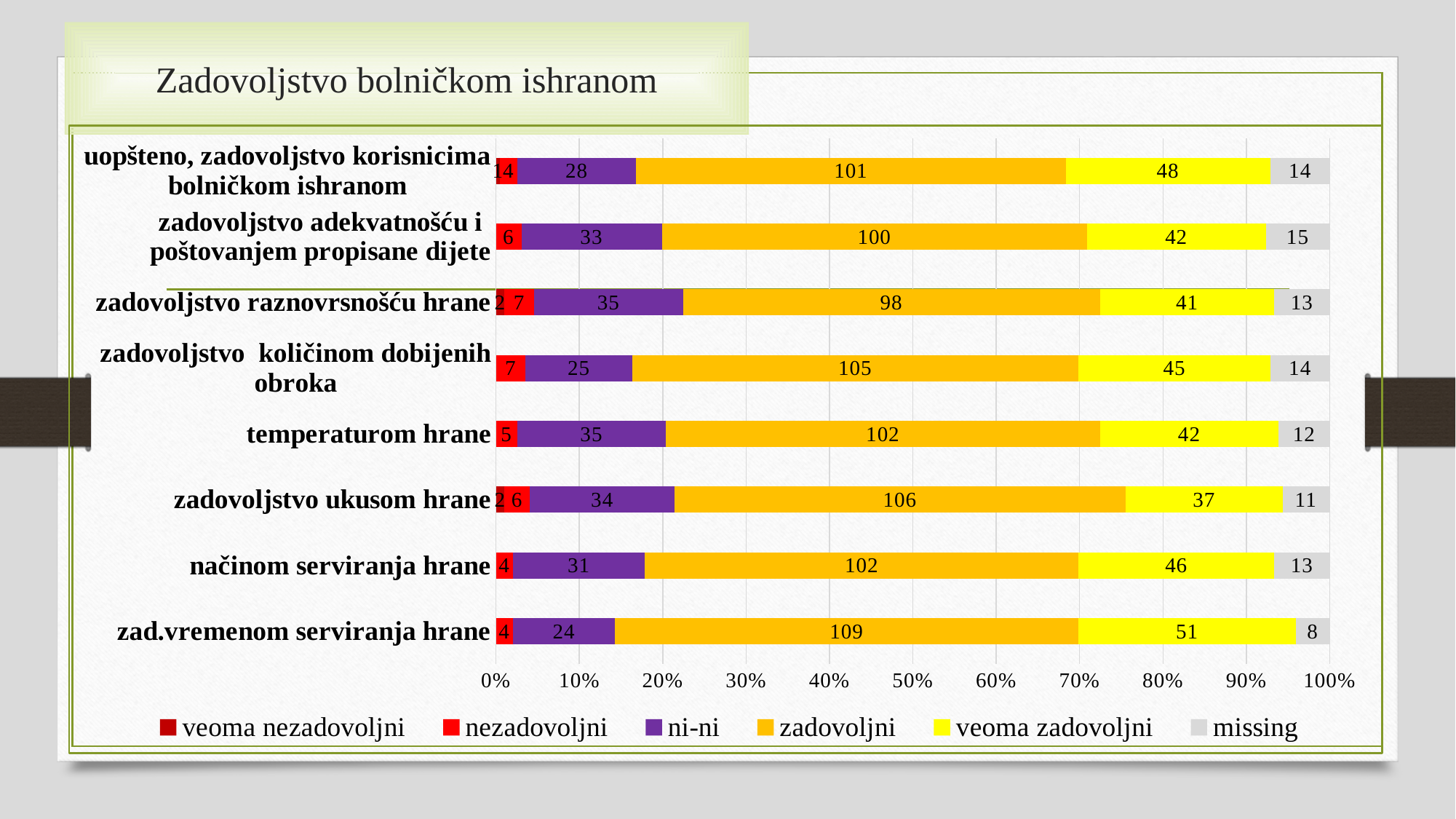
How many categories are plotted on the chart? 8 Which category has the lowest 'missing' value? zad.vremenom serviranja hrane What is the 'veoma zadovoljni' value for 'zadovoljstvo ukusom hrane'? 37 What is the difference between the 'veoma zadovoljni' values for 'zad.vremenom serviranja hrane' and 'zadovoljstvo ukusom hrane'? 14 How many series does the legend list? 6 What is the 'zadovoljni' value for 'zad.vremenom serviranja hrane'? 109 Which category has the highest 'zadovoljni' value? zad.vremenom serviranja hrane What is the 'missing' value for 'temperaturom hrane'? 12 Which is larger: the 'ni-ni' value for 'temperaturom hrane' or for 'zadovoljstvo količinom dobijenih obroka'? temperaturom hrane What is the 'ni-ni' value for 'zadovoljstvo adekvatnošću i poštovanjem propisane dijete'? 33 What type of chart is shown on the slide? stacked bar chart What is the total of all segments in the bar for 'zadovoljstvo raznovrsnošću hrane'? 196